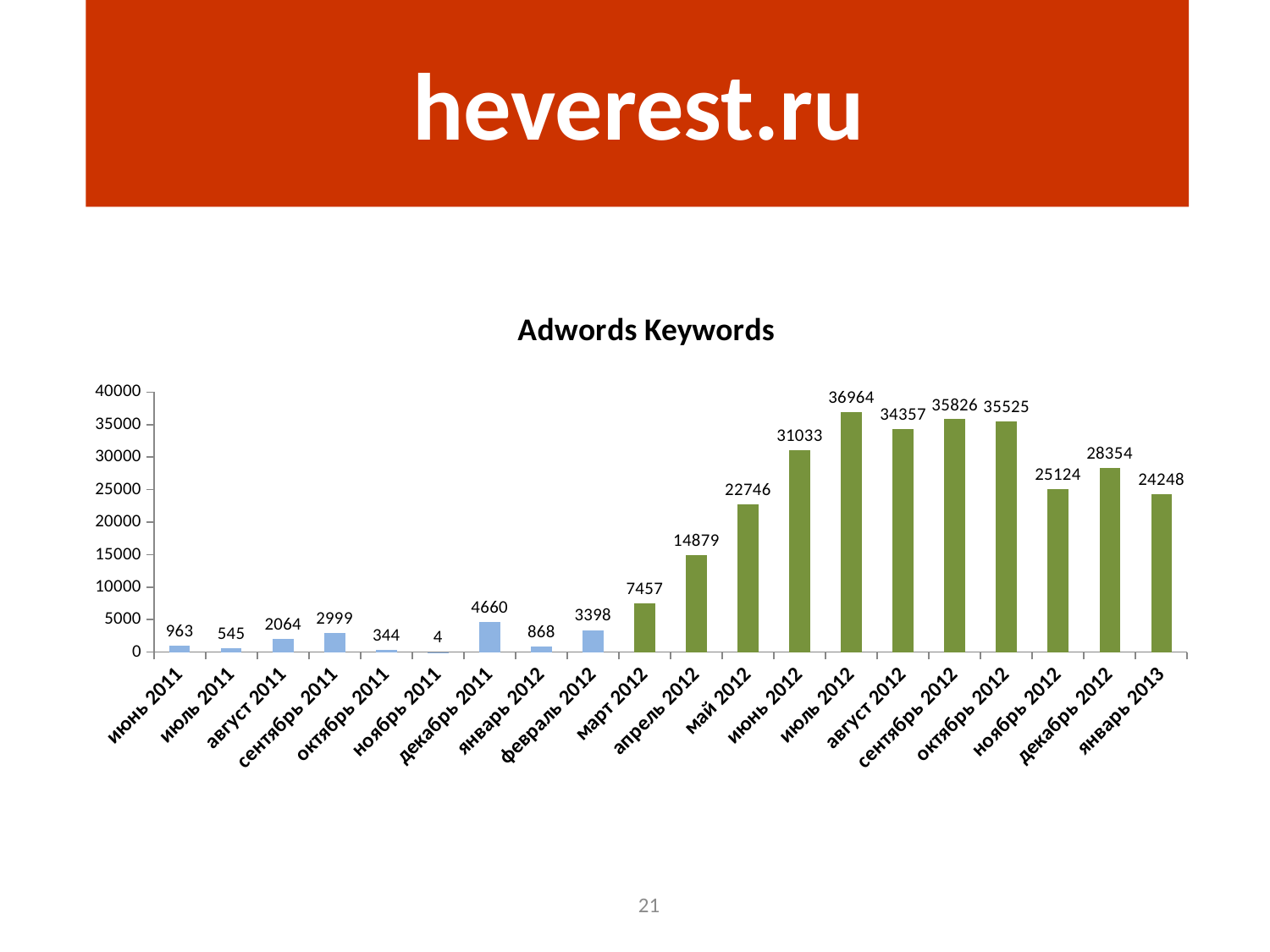
What is the value for июль 2012? 36964 Is the value for май 2012 greater or less than 20000? greater What is the difference between the values for декабрь 2012 and ноябрь 2012? 3230 What is the title of the chart? Adwords Keywords Which month has the lowest value? ноябрь 2011 Which is larger, the value for август 2012 or the value for сентябрь 2012? сентябрь 2012 What is the difference between the values for июль 2012 and июнь 2012? 5931 What is the value for ноябрь 2011? 4 Which month has the highest value? июль 2012 What is the value for декабрь 2011? 4660 How many months (categories) are plotted in the Adwords Keywords chart? 20 What type of chart is shown on the slide? bar chart